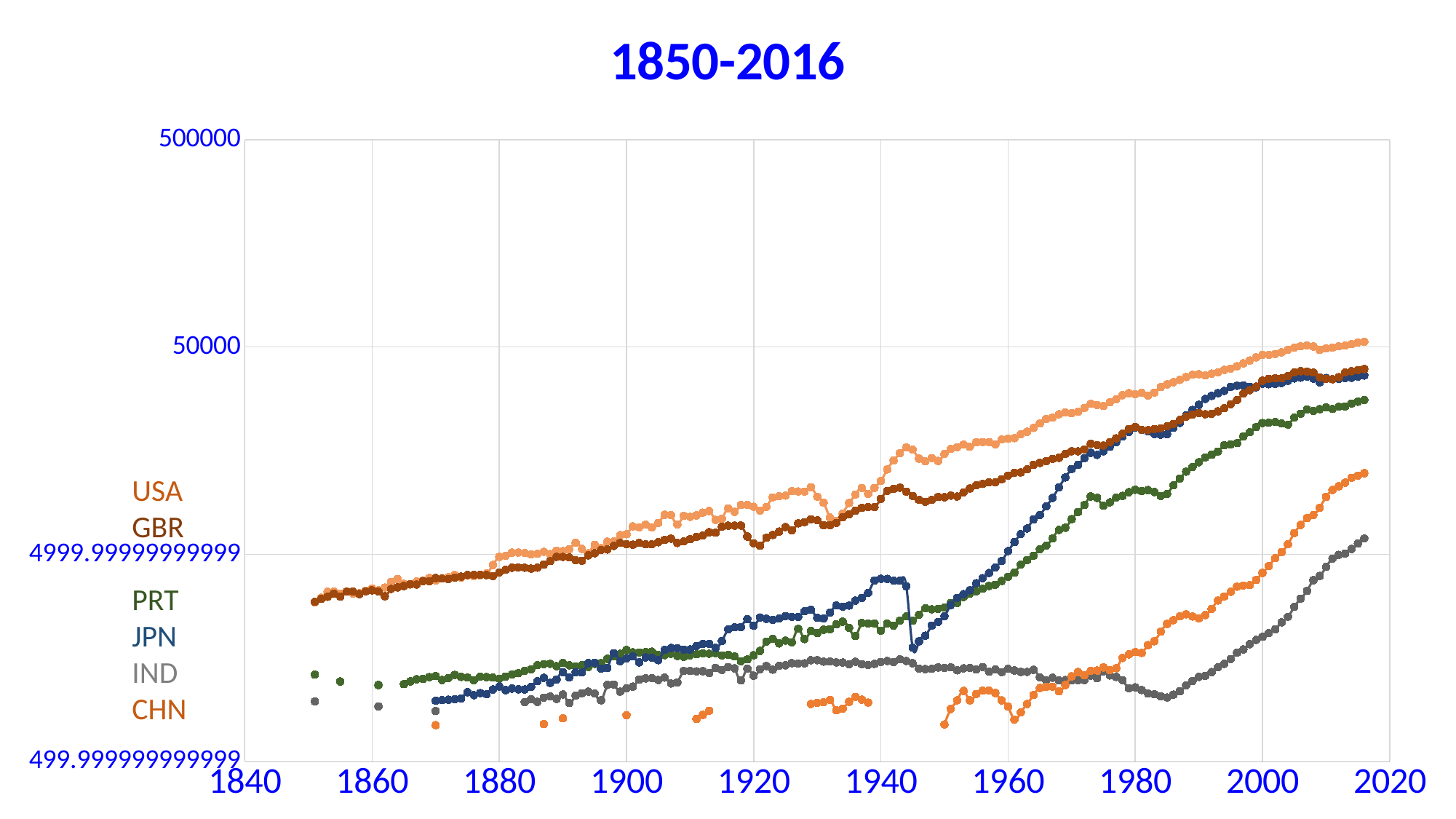
Does the USA series generally rise or fall from 1850 to 2016? rise Which series has the lowest value at the right end of the chart (2016)? IND Which series is larger in 2016, JPN or IND? JPN Is the value for IND in 1985 greater or less than 4999.9999999999? less Which series shows a sharp drop around 1945? JPN Is the value for PRT in 2016 greater or less than 50000? less What is the title of the chart? 1850-2016 How many series does the chart show? 6 Which series has the highest value at the right end of the chart (2016)? USA Is the value for GBR in 2016 greater or less than 50000? less Which series is larger around 1960, JPN or PRT? JPN What kind of chart is shown on the slide? line chart